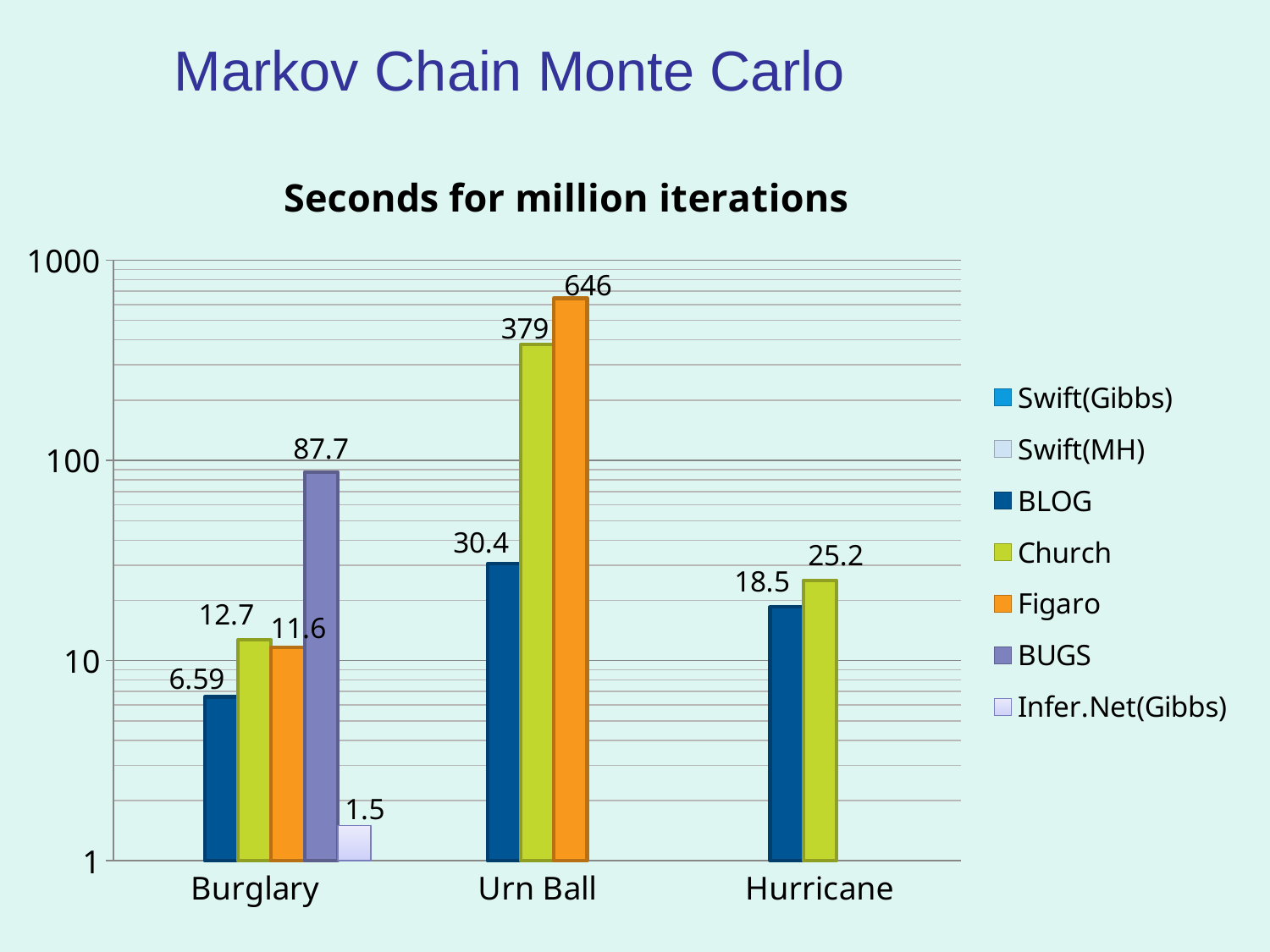
What is the value for Figaro in the Urn Ball category? 646 What is the value for BUGS in the Burglary category? 87.7 Is the value for Church in the Urn Ball category greater or less than 100? greater What is the title of the chart? Seconds for million iterations How many series does the legend list? 7 In the Burglary category, which is larger: the Church value or the Figaro value? Church How many categories are shown on the x axis? 3 What is the difference between the Church and BLOG values in the Hurricane category? 6.7 What is the value for Church in the Hurricane category? 25.2 Which series has the highest value in the Urn Ball category? Figaro What is the value for BLOG in the Burglary category? 6.59